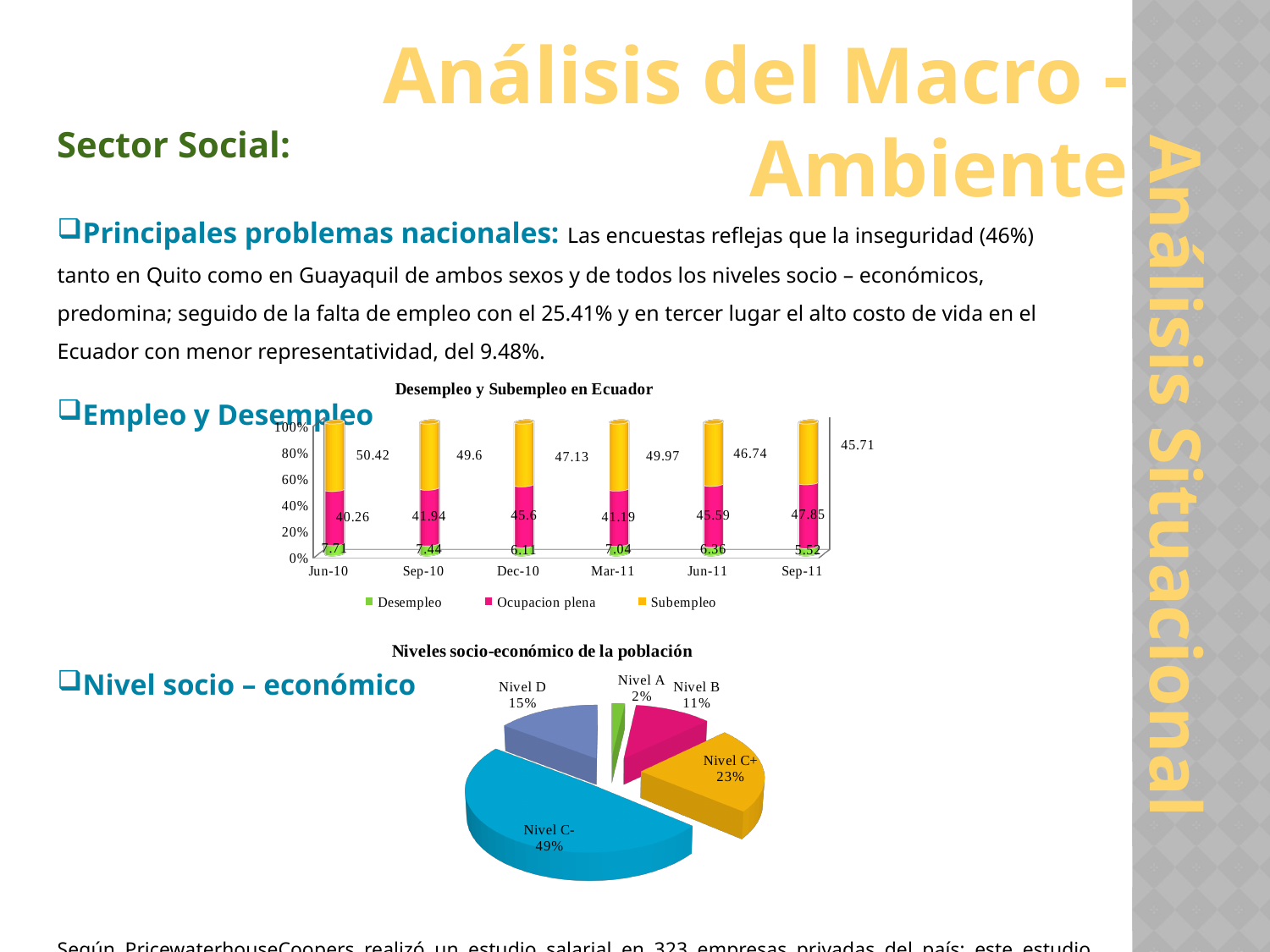
In the 'Niveles socio-económico de la población' chart, which level has the smallest share? Nivel A In the 'Niveles socio-económico de la población' chart, what share does Nivel C- have? 49% In the 'Desempleo y Subempleo en Ecuador' chart, how many series does the legend list? 3 In the 'Desempleo y Subempleo en Ecuador' chart, which period has the highest Subempleo value? Jun-10 In the 'Desempleo y Subempleo en Ecuador' chart, which period has the lowest Desempleo value? Sep-11 What kind of chart is 'Niveles socio-económico de la población'? Pie chart In the 'Desempleo y Subempleo en Ecuador' chart, what is the Ocupacion plena value for Sep-11? 47.85 In the 'Desempleo y Subempleo en Ecuador' chart, what is the difference between the Subempleo values for Jun-10 and Sep-11? 4.71 In the 'Desempleo y Subempleo en Ecuador' chart, what is the Desempleo value for Dec-10? 6.11 In the 'Desempleo y Subempleo en Ecuador' chart, what is the Subempleo value for Jun-10? 50.42 In the 'Desempleo y Subempleo en Ecuador' chart, how many periods are shown on the x axis? 6 In the 'Desempleo y Subempleo en Ecuador' chart, does the Desempleo value for Jun-10 or Jun-11 have the larger value? Jun-10